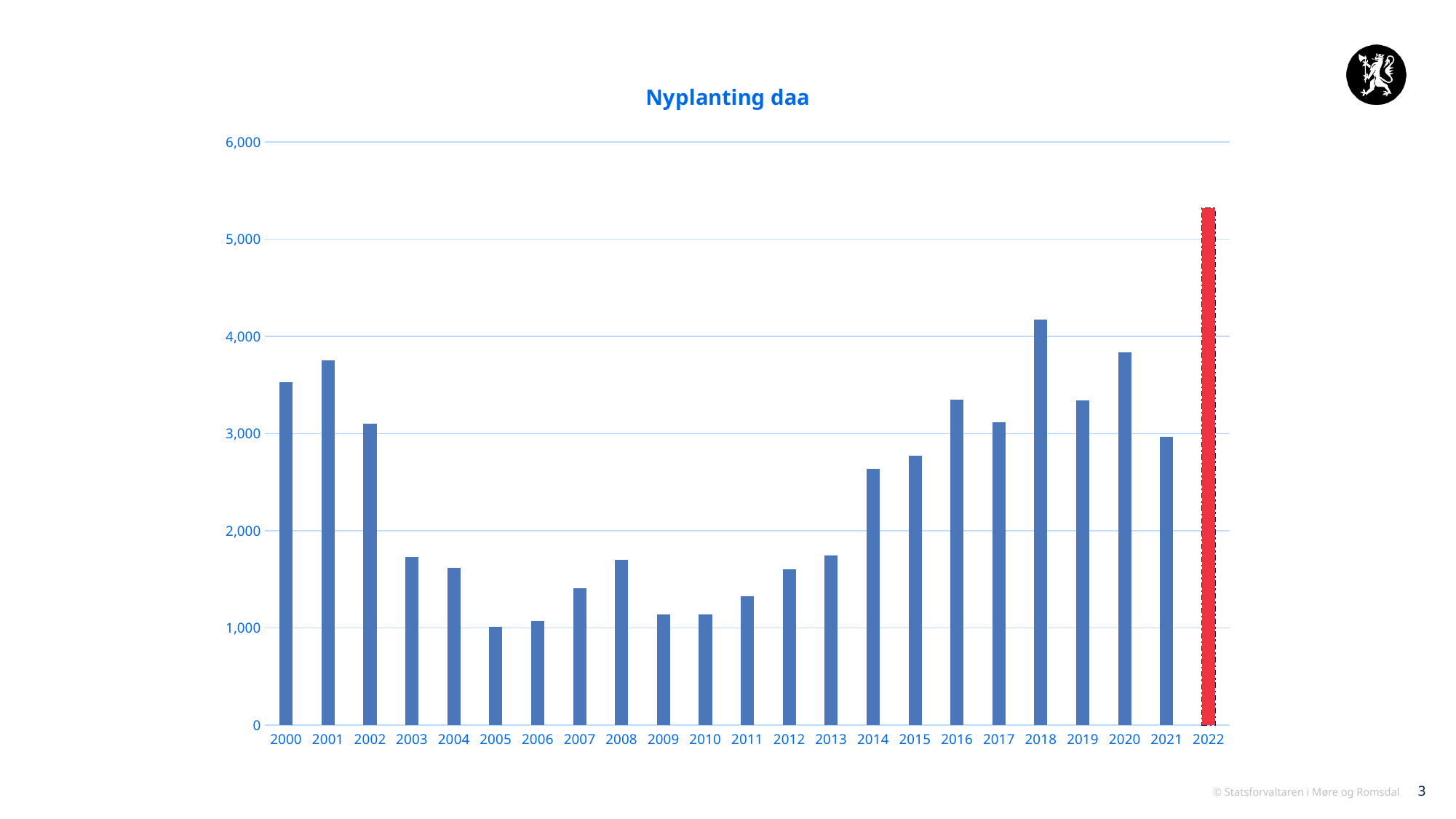
Do the values rise or fall from 2002 to 2005? fall What kind of chart is shown on the slide? bar chart Which year has the highest value in the chart? 2022 Is the value for 2018 greater or less than 4,000? greater How many years (bars) are plotted in the chart? 23 Is the value for 2022 greater or less than 5,000? greater What is the title of the chart? Nyplanting daa Is the value for 2014 greater or less than 2,000? greater Which year has the larger value, 2018 or 2020? 2018 Which bar is coloured red instead of blue? 2022